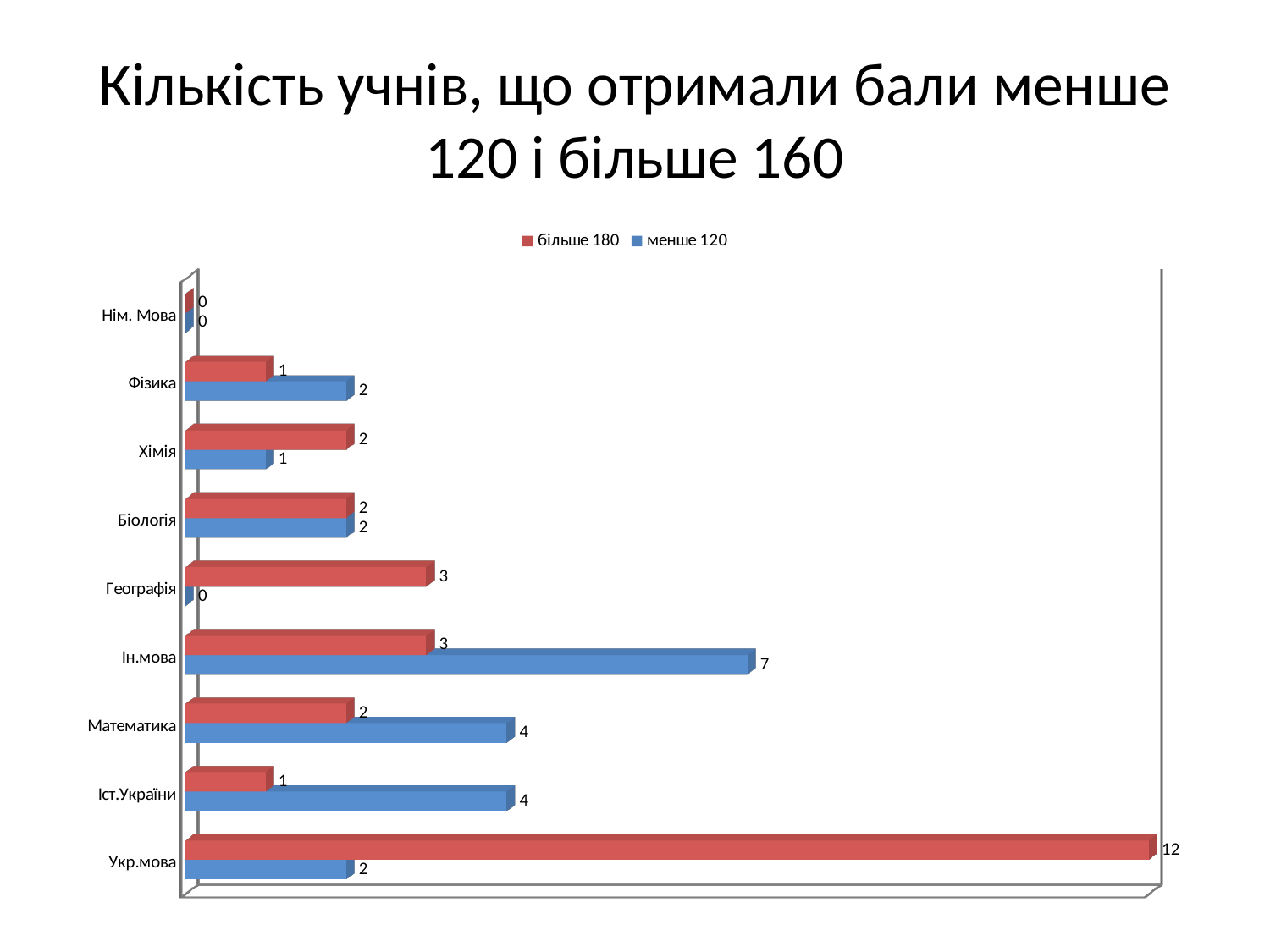
What is the value for Ін.мова in the менше 120 series? 7 Which is larger for Математика: the більше 180 value or the менше 120 value? менше 120 Which category has the highest value in the менше 120 series? Ін.мова Which colour represents the менше 120 series? Blue How many series does the legend list? 2 How many categories are shown on the chart? 9 What kind of chart is shown on the slide? Bar chart Which category has the highest value in the більше 180 series? Укр.мова What is the difference between the більше 180 values for Укр.мова and Географія? 9 What is the value for Укр.мова in the більше 180 series? 12 What is the difference between the менше 120 and більше 180 values for Ін.мова? 4 What is the value for Географія in the менше 120 series? 0